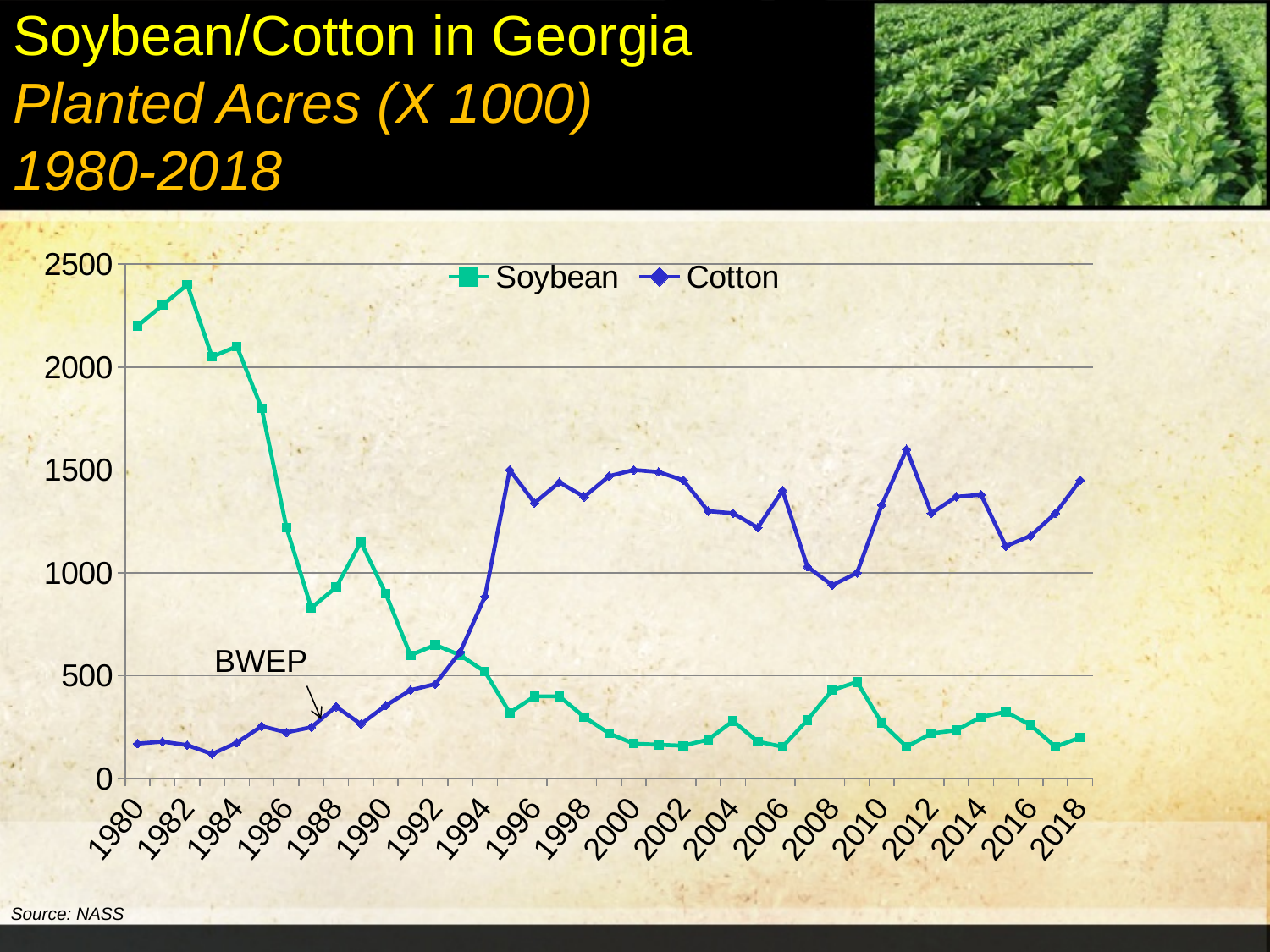
Is the Soybean value for 1980 greater or less than 2000? greater Does the Soybean series rise or fall from 1980 to 1994? fall Is the Soybean value for 2018 greater or less than 500? less What kind of chart is shown on the slide? Line chart In which year does the Cotton series reach its highest value? 2011 Is the Cotton value for 2011 greater or less than 1500? greater In 2018, which series has the larger value, Soybean or Cotton? Cotton What are the two series named in the legend? Soybean and Cotton How many series does the legend list? 2 In which year does the Soybean series reach its highest value? 1982 In 1980, which series has the larger value, Soybean or Cotton? Soybean